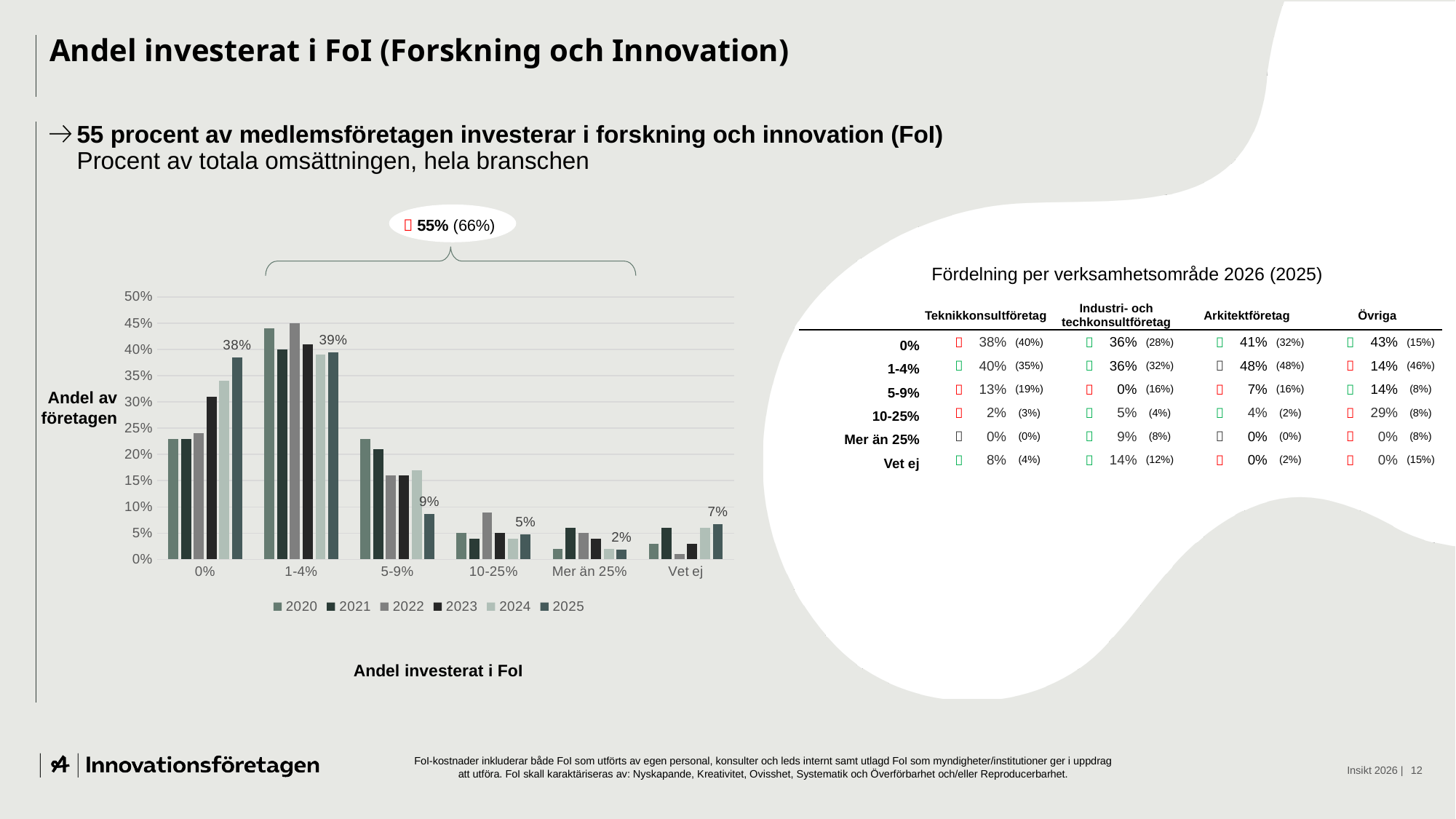
How many series does the chart legend list? 6 What is the 2025 value for the Mer än 25% category? 2% Which is larger for 2025: the value for 5-9% or the value for 10-25%? 5-9% How many categories are shown on the x axis of the chart? 6 What is the 2025 value for the 0% category? 38% Which category has the lowest 2025 value? Mer än 25% What kind of chart is shown on the slide? Bar chart Is the 2020 value for the 0% category greater or less than 25%? less What is the 2025 value for the 1-4% category? 39% Is the 2022 value for the 1-4% category greater or less than 40%? greater What is the difference between the 2025 values for 5-9% and Vet ej? 2 percentage points What is the 2025 value for the Vet ej category? 7%